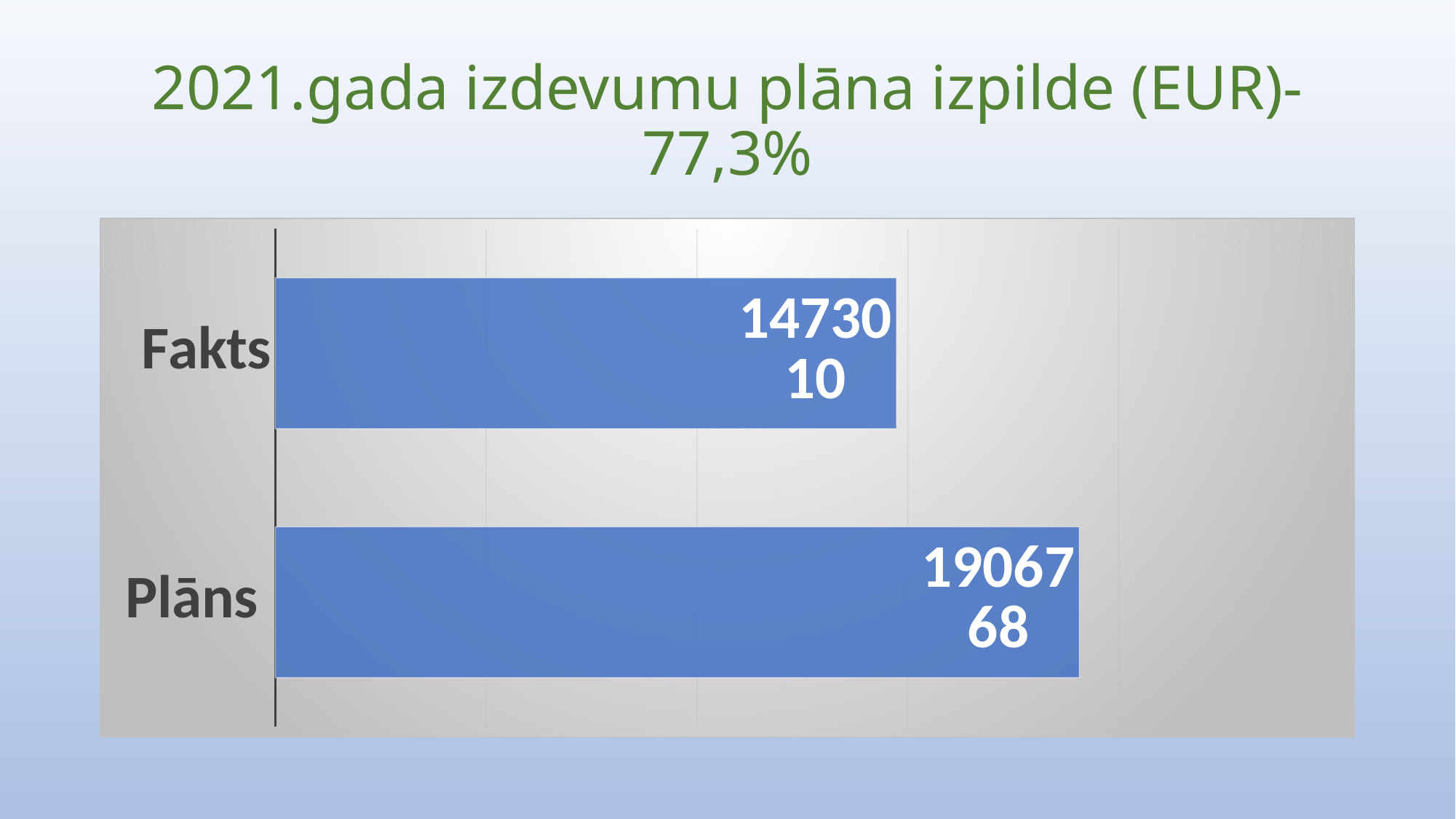
What colour are the bars in the chart? Blue What is the title of the slide? 2021.gada izdevumu plāna izpilde (EUR)- 77,3% Which category has the lowest value? Fakts How many categories are shown in the chart? 2 What is the difference between the values for Plāns and Fakts? 433758 What is the value for Fakts? 1473010 Which is larger, the value for Fakts or the value for Plāns? Plāns What kind of chart is shown on the slide? Bar chart Which category has the highest value? Plāns What is the value for Plāns? 1906768